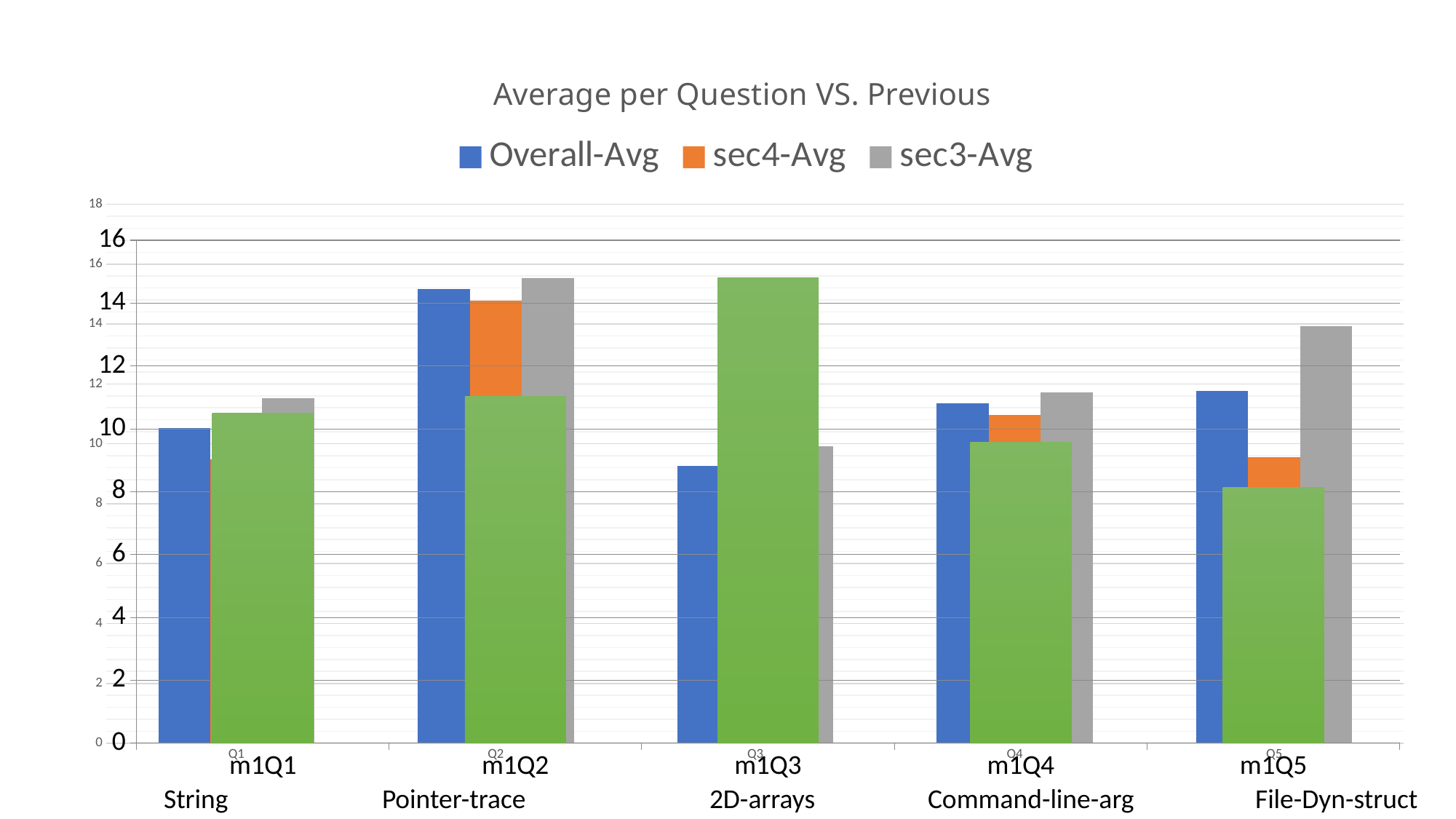
Is the Overall-Avg value for m1Q2 greater or less than 12? greater Which category has the highest sec3-Avg value? m1Q2 How many question categories are shown along the x axis? 5 What kind of chart is shown on the slide? bar chart For m1Q5, which is larger: the Overall-Avg value or the sec3-Avg value? sec3-Avg Which category has the highest Overall-Avg value? m1Q2 What is the title of the chart? Average per Question VS. Previous Is the Overall-Avg value for m1Q3 greater or less than 10? less Is the sec3-Avg value for m1Q5 greater or less than 12? greater Which category has the lowest sec3-Avg value? m1Q3 Which category has the lowest Overall-Avg value? m1Q3 How many series does the chart legend list? 3